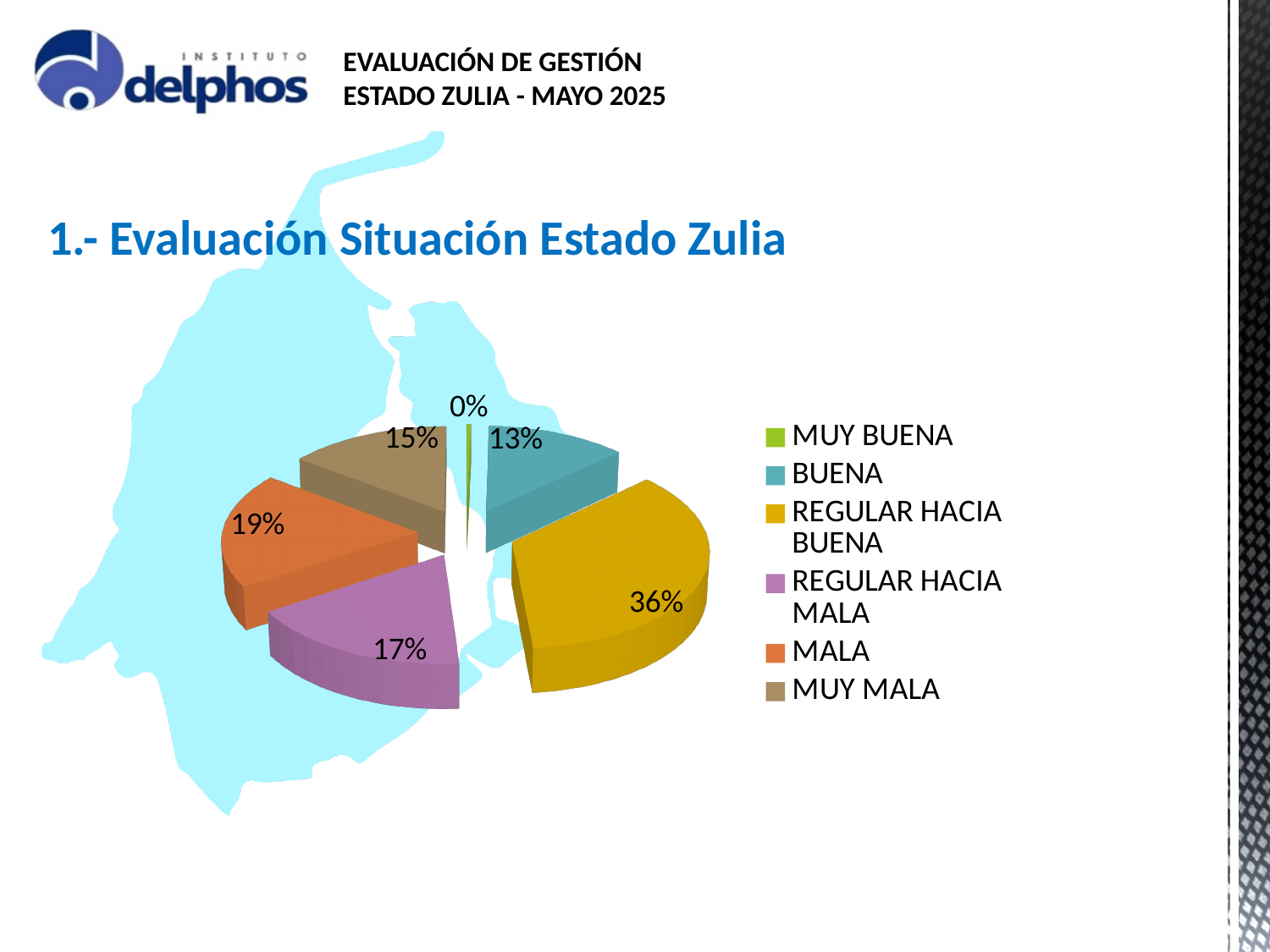
How many categories does the legend list? 6 What percentage corresponds to the MUY MALA slice? 15% What is the difference in percentage points between REGULAR HACIA BUENA and REGULAR HACIA MALA? 19 What percentage of respondents rated the situation as REGULAR HACIA BUENA? 36% Which is larger, the MALA slice or the MUY MALA slice? MALA What colour is the REGULAR HACIA MALA slice? purple What percentage corresponds to the BUENA slice? 13% What percentage corresponds to the MALA slice? 19% Which category has the smallest share of the pie? MUY BUENA Which category has the largest share of the pie? REGULAR HACIA BUENA What kind of chart is shown on the slide? pie chart What percentage corresponds to the MUY BUENA slice? 0%